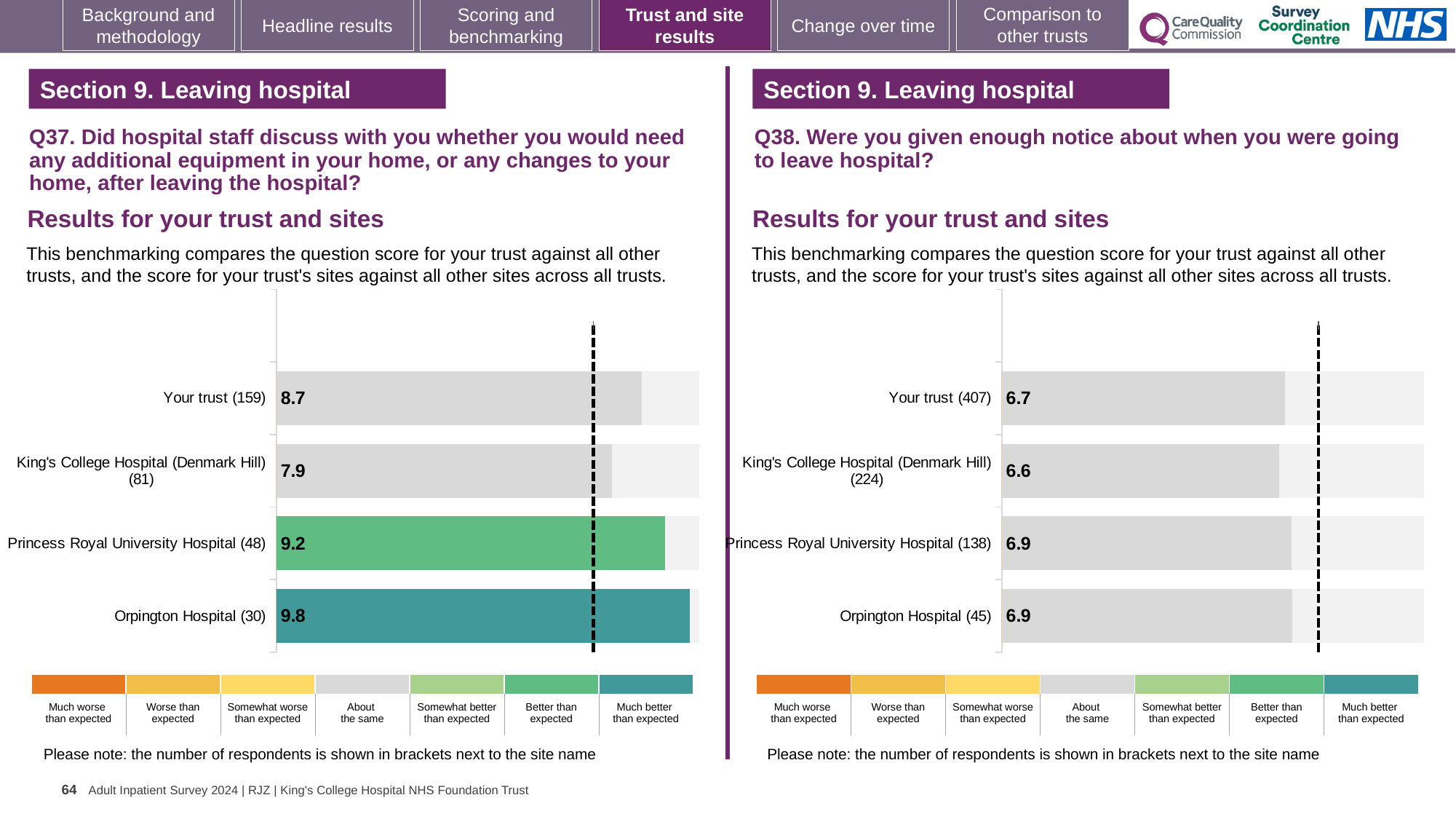
In the Q37 chart on the left, what is the score for Orpington Hospital (30)? 9.8 How many sites or trusts are plotted in the Q38 chart on the right? 4 In the Q37 chart on the left, what is the score for Your trust (159)? 8.7 In the Q37 chart on the left, what is the difference between the scores for Orpington Hospital (30) and King's College Hospital (Denmark Hill) (81)? 1.9 In the Q38 chart on the right, which site or trust has the lowest score? King's College Hospital (Denmark Hill) (224) In the Q37 chart on the left, which site or trust has the highest score? Orpington Hospital (30) What kind of chart is the Q37 chart on the left? Bar chart In the Q38 chart on the right, what is the score for Princess Royal University Hospital (138)? 6.9 In the Q37 chart on the left, which site or trust has the lowest score? King's College Hospital (Denmark Hill) (81) In the Q38 chart on the right, what is the score for King's College Hospital (Denmark Hill) (224)? 6.6 In the Q37 chart on the left, which benchmark category does the colour of the Orpington Hospital (30) bar indicate? Much better than expected In the Q38 chart on the right, which has the larger score: Your trust (407) or Princess Royal University Hospital (138)? Princess Royal University Hospital (138)